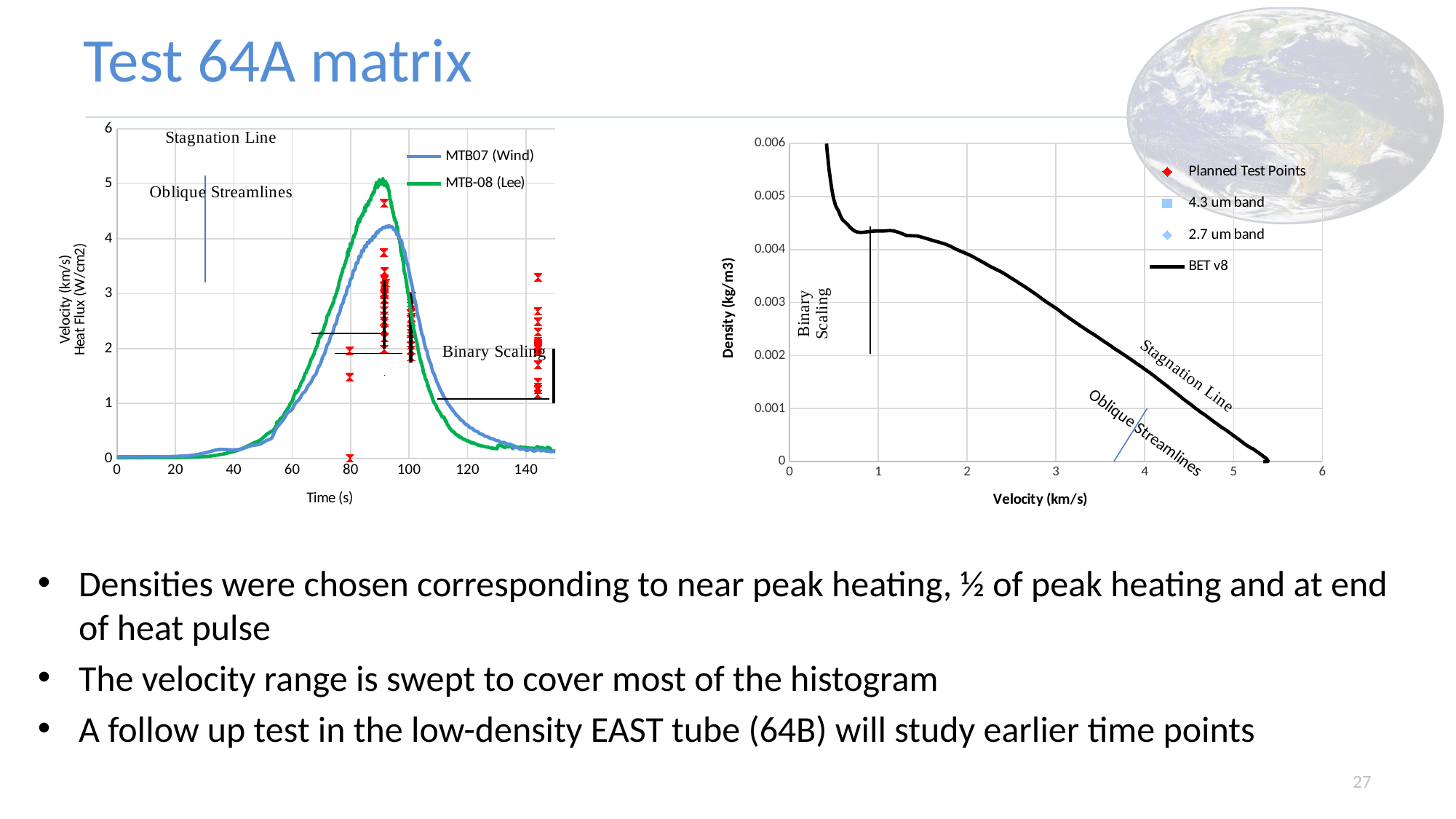
In the right chart, does the BET v8 line rise or fall as velocity increases from 1 to 5 km/s? fall In the left chart, which series reaches the higher peak, MTB07 (Wind) or MTB-08 (Lee)? MTB-08 (Lee) How many series does the legend of the left chart list? 2 What kind of chart is the left chart (Time (s) on the x axis)? line chart In the left chart, is the value of MTB07 (Wind) at time 40 s greater or less than 1? less In the right chart, what is the name of the series drawn as a black line in the legend? BET v8 In the right chart, is the BET v8 density at a velocity of 1 km/s greater or less than 0.004? greater How many entries does the legend of the right chart (Density vs Velocity) list? 4 In the left chart, is the peak value of MTB07 (Wind) greater or less than 5? less What is the x-axis title of the left chart? Time (s)